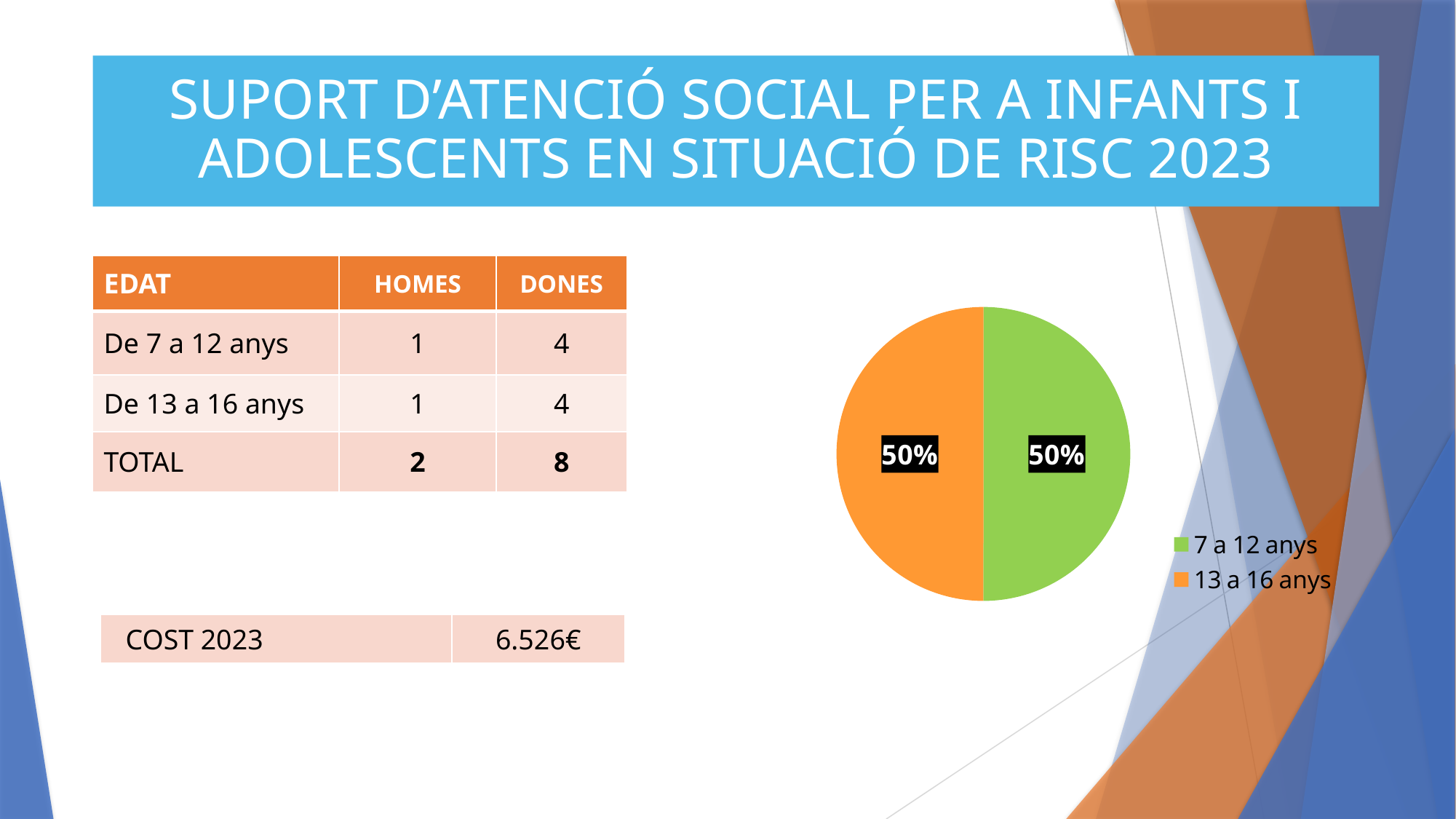
What is the data label shown on the green slice of the pie chart? 50% Which colour represents "7 a 12 anys" in the pie chart? green What is the data label shown on the orange slice of the pie chart? 50% What share of the pie does the "7 a 12 anys" slice represent? 50% Is the share of the "13 a 16 anys" slice greater or less than 25%? greater How many slices does the pie chart have? 2 Which colour represents "13 a 16 anys" in the pie chart? orange What kind of chart is shown on the slide? pie chart What share of the pie does the "13 a 16 anys" slice represent? 50% How many entries does the pie chart's legend list? 2